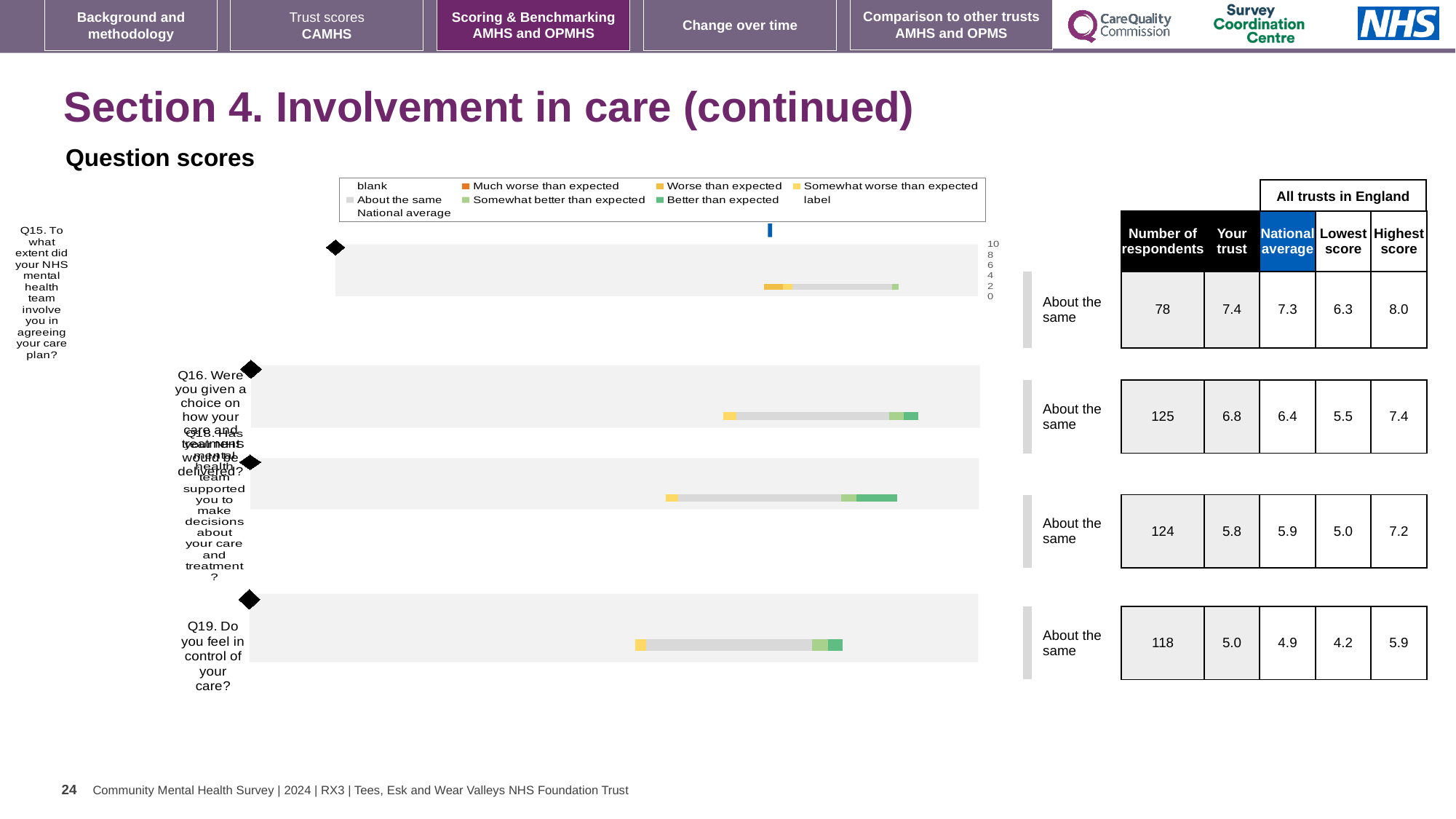
How many questions are plotted on this slide? 4 Which question has the highest 'Your trust' score on this slide? Q15 What is the national average score for Q19 (Do you feel in control of your care?)? 4.9 What kind of chart is used to show the question scores? Bar chart By how much does the 'Your trust' score for Q16 exceed the national average for Q16? 0.4 What benchmark category is shown for Q19 (Do you feel in control of your care?)? About the same How many respondents are listed for Q15 (To what extent did your NHS mental health team involve you in agreeing your care plan?)? 78 What is the 'Your trust' score for Q16 (Were you given a choice on how your care and treatment would be delivered?)? 6.8 For Q18, which is larger: the 'Your trust' score or the national average? National average What is the highest score across all trusts in England for Q18? 7.2 What is the difference between the highest score and the lowest score for Q15? 1.7 Which question has the lowest 'Lowest score' value in the table? Q19